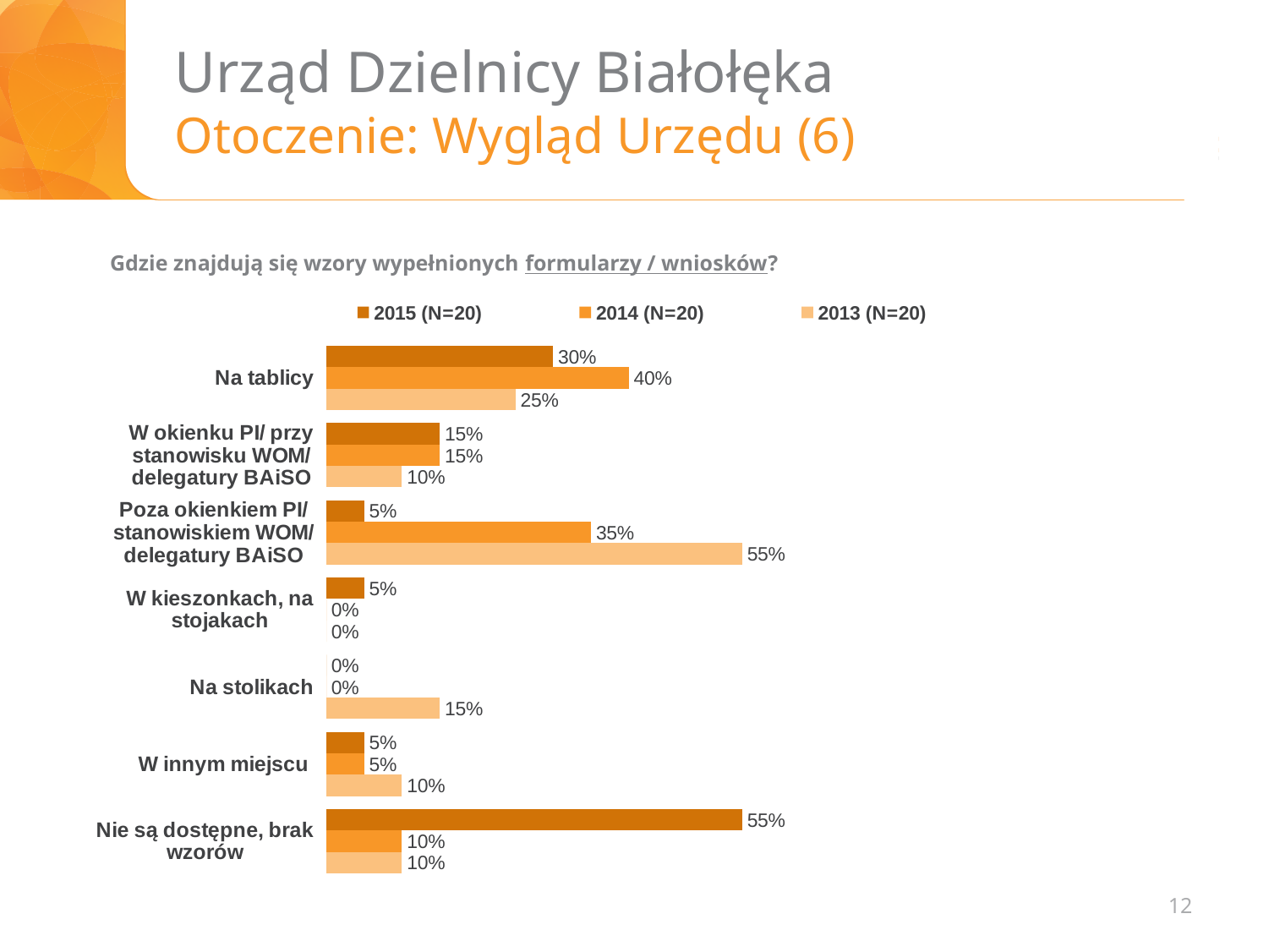
What is the value for "Na stolikach" in the 2013 (N=20) series? 15% How many series does the legend list? 3 Which category has the highest value in the 2014 (N=20) series? Na tablicy What is the value for "Na tablicy" in the 2014 (N=20) series? 40% Which category has the highest value in the 2015 (N=20) series? Nie są dostępne, brak wzorów How many categories are shown on the chart? 7 What is the value for "Poza okienkiem PI/ stanowiskiem WOM/ delegatury BAiSO" in the 2013 (N=20) series? 55% What kind of chart is shown on the slide? Bar chart What is the value for "Nie są dostępne, brak wzorów" in the 2015 (N=20) series? 55% What is the difference between the 2014 (N=20) and 2015 (N=20) values for "Poza okienkiem PI/ stanowiskiem WOM/ delegatury BAiSO"? 30% For "Na tablicy", which series has the larger value: 2015 (N=20) or 2013 (N=20)? 2015 (N=20) What question is the chart about, as stated above it? Gdzie znajdują się wzory wypełnionych formularzy / wniosków?